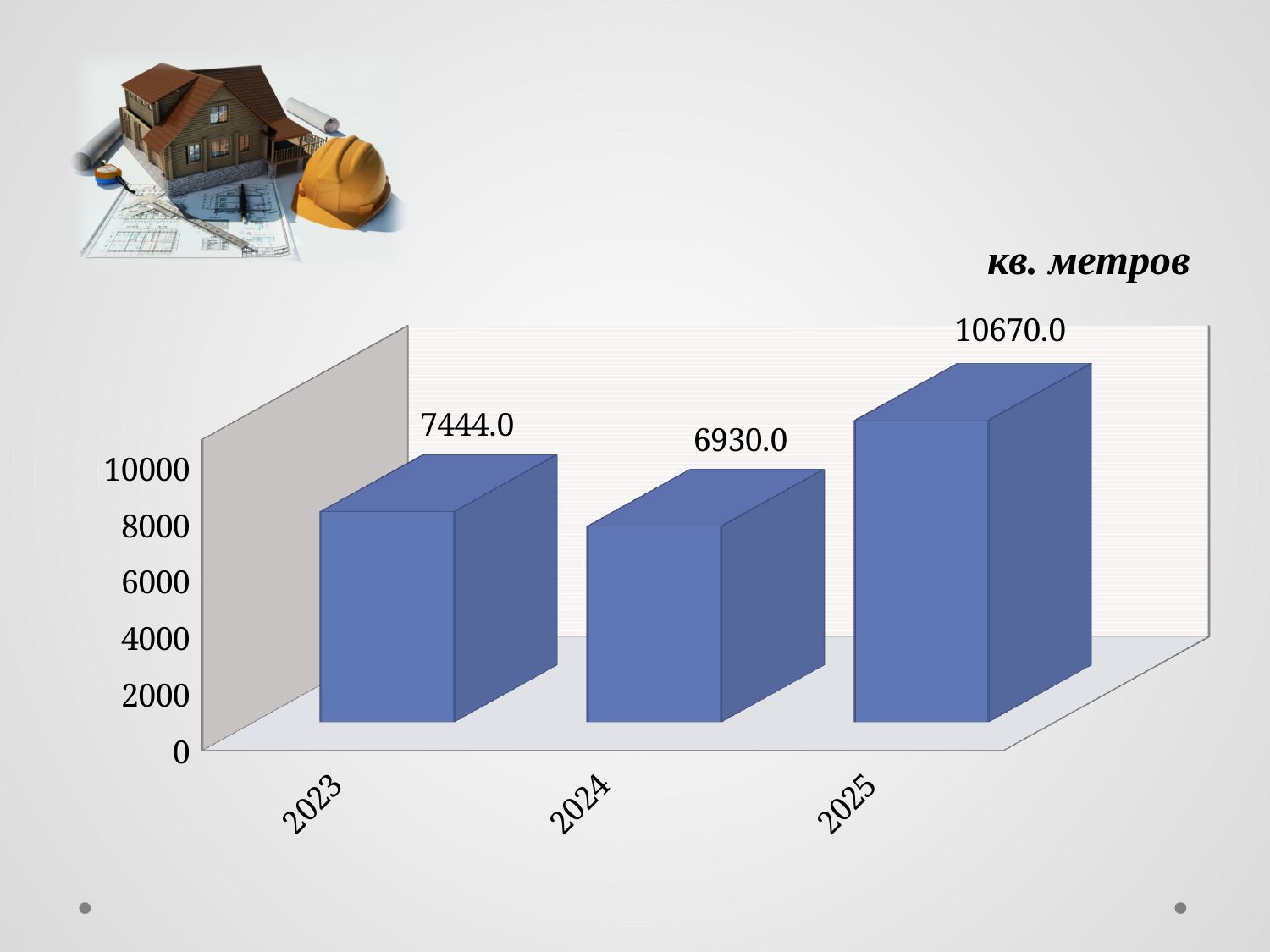
What is the value for 2024? 6930.0 Which year has the highest value? 2025 How many years are shown on the chart? 3 Which is larger, the value for 2023 or the value for 2024? 2023 What unit label is shown above the chart? кв. метров What is the value for 2023? 7444.0 Which year has the lowest value? 2024 What is the value for 2025? 10670.0 What kind of chart is shown on the slide? bar chart What is the difference between the values for 2025 and 2023? 3226.0 What is the difference between the values for 2023 and 2024? 514.0 Is the value for 2025 greater or less than 10000? greater